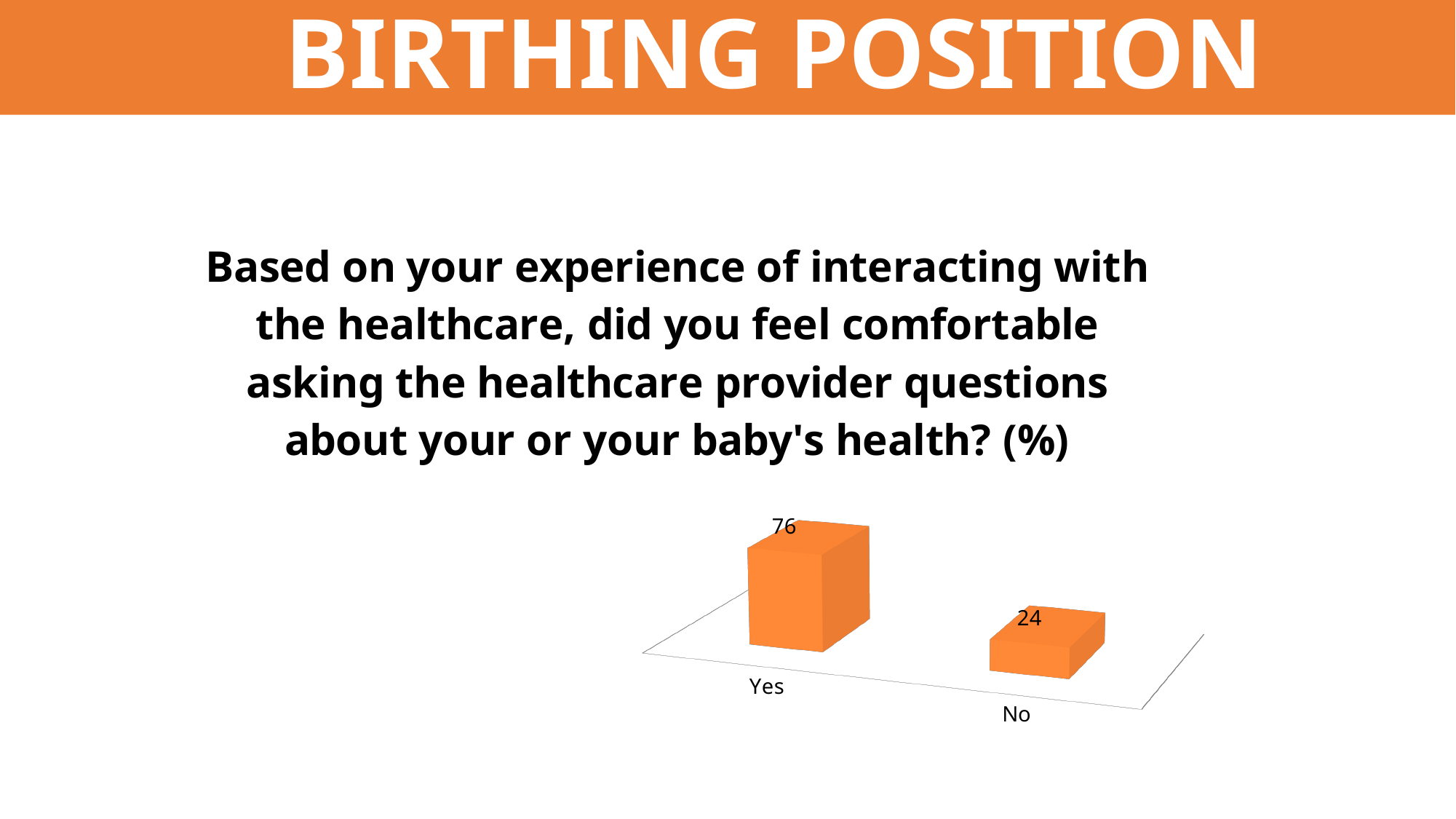
Which category has the lowest value? No How many categories are shown in the chart? 2 What colour are the bars in the chart? Orange What is the title shown in the orange banner at the top of the slide? BIRTHING POSITION What is the value for No? 24 What is the value for Yes? 76 What is the total of the two values shown in the chart? 100 Which category has the highest value? Yes Which is larger, the value for Yes or the value for No? Yes What is the difference between the values for Yes and No? 52 What kind of chart is shown on the slide? Bar chart